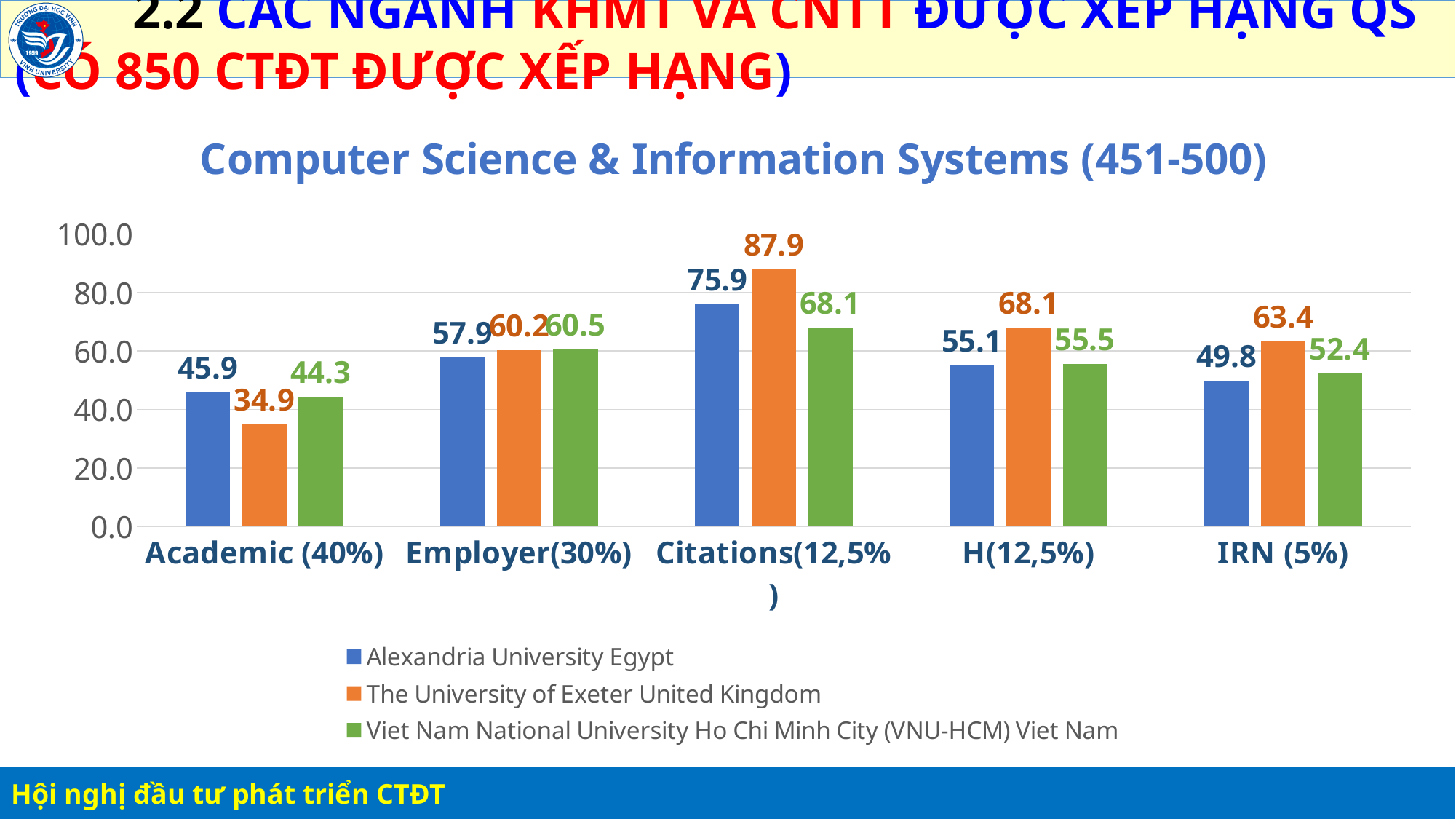
What is the H(12,5%) value for The University of Exeter United Kingdom? 68.1 In which category does The University of Exeter United Kingdom have its highest value? Citations(12,5%) What is the Citations(12,5%) value for The University of Exeter United Kingdom? 87.9 What kind of chart is shown on the slide? Bar chart How many series does the legend list? 3 Is the Employer(30%) value for Alexandria University Egypt greater or less than 60.0? less What is the IRN (5%) value for Viet Nam National University Ho Chi Minh City (VNU-HCM) Viet Nam? 52.4 What is the Academic (40%) value for Alexandria University Egypt? 45.9 What is the difference between The University of Exeter United Kingdom and Alexandria University Egypt in the Citations(12,5%) category? 12.0 In the Academic (40%) category, which is larger: Alexandria University Egypt or The University of Exeter United Kingdom? Alexandria University Egypt In which category does Alexandria University Egypt have its lowest value? Academic (40%) How many categories are shown on the x axis? 5